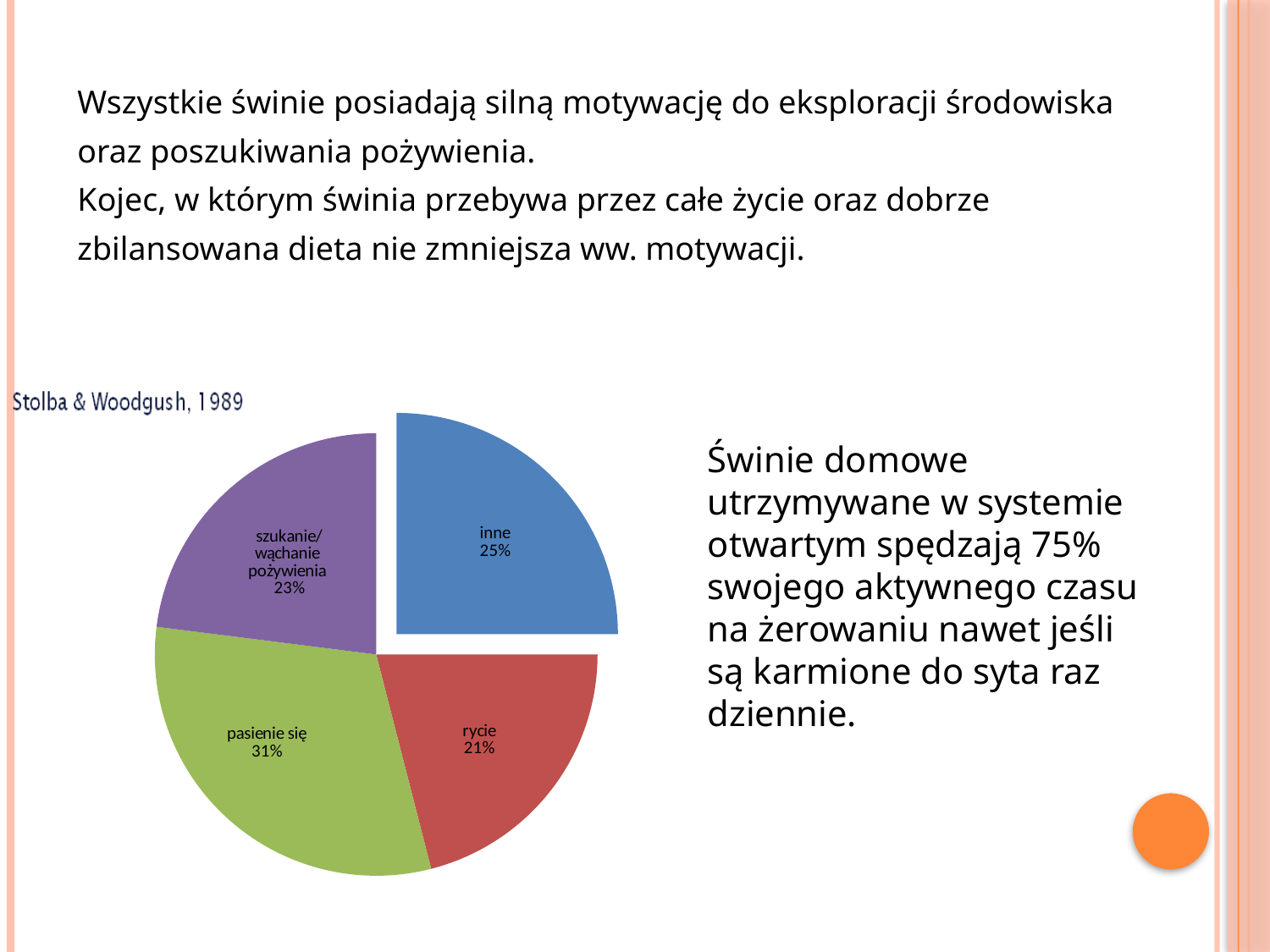
What share of the pie does "rycie" represent? 21% Which is larger, the share for "inne" or the share for "szukanie/wąchanie pożywienia"? inne What colour is the "inne" slice of the pie chart? blue Which slice of the pie chart is the largest? pasienie się What share of the pie does "inne" represent? 25% What share of the pie does "szukanie/wąchanie pożywienia" represent? 23% Which slice of the pie chart is the smallest? rycie How many slices does the pie chart have? 4 What is the combined share of "pasienie się", "rycie" and "szukanie/wąchanie pożywienia"? 75% What kind of chart is shown on the slide? pie chart What is the difference in percentage points between "pasienie się" and "rycie"? 10